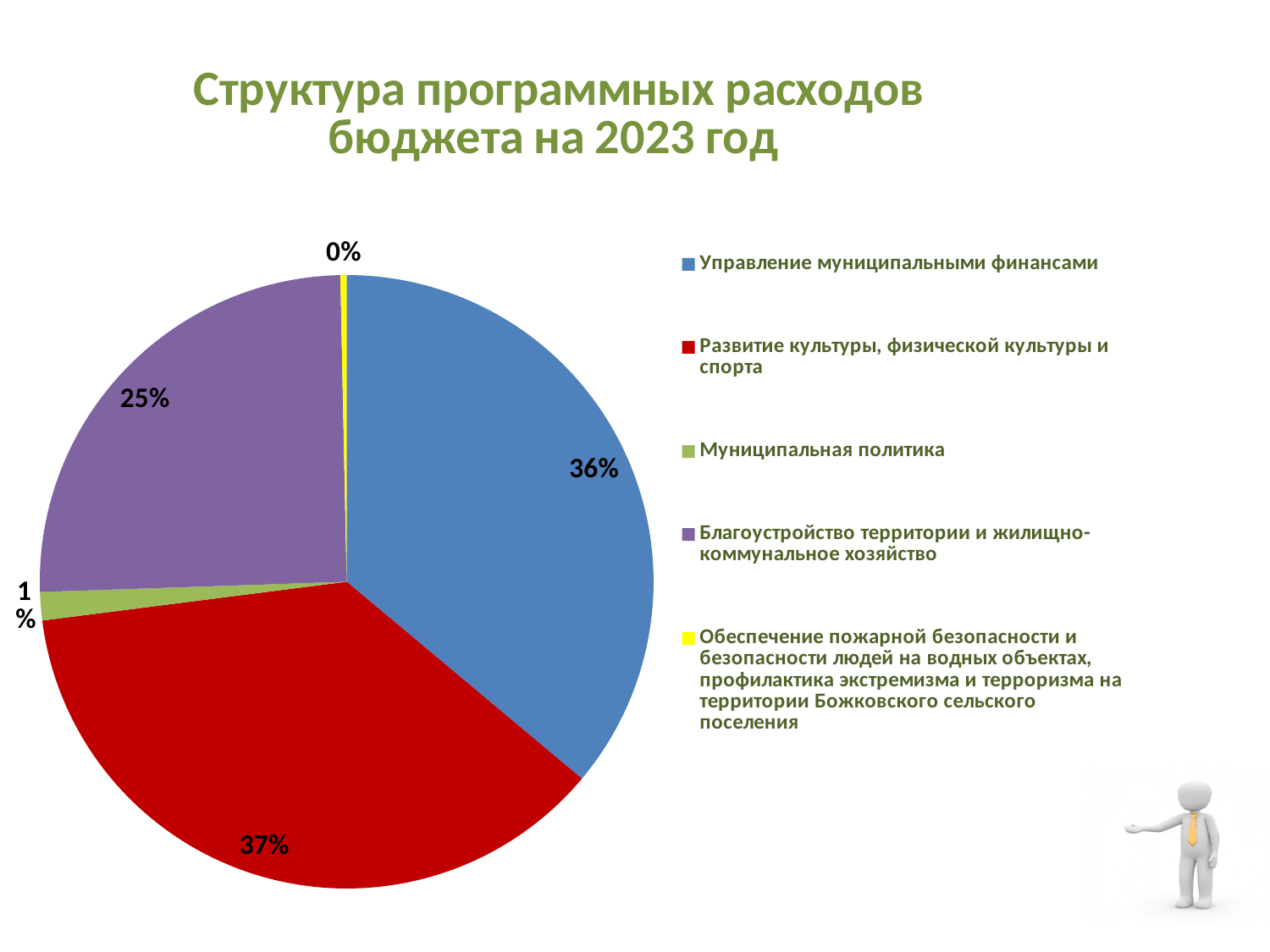
Which category has the smallest share of the pie? Обеспечение пожарной безопасности и безопасности людей на водных объектах, профилактика экстремизма и терроризма на территории Божковского сельского поселения What is the difference in percentage points between "Развитие культуры, физической культуры и спорта" and "Благоустройство территории и жилищно-коммунальное хозяйство"? 12 How many categories does the legend list? 5 What share of the pie does "Благоустройство территории и жилищно-коммунальное хозяйство" have? 25% Which is larger: the share for "Управление муниципальными финансами" or the share for "Благоустройство территории и жилищно-коммунальное хозяйство"? Управление муниципальными финансами What share of the pie does "Муниципальная политика" have? 1% What is the title of the slide? Структура программных расходов бюджета на 2023 год What share of the pie does "Управление муниципальными финансами" have? 36% Which category has the largest share of the pie? Развитие культуры, физической культуры и спорта What type of chart is shown on the slide? pie chart